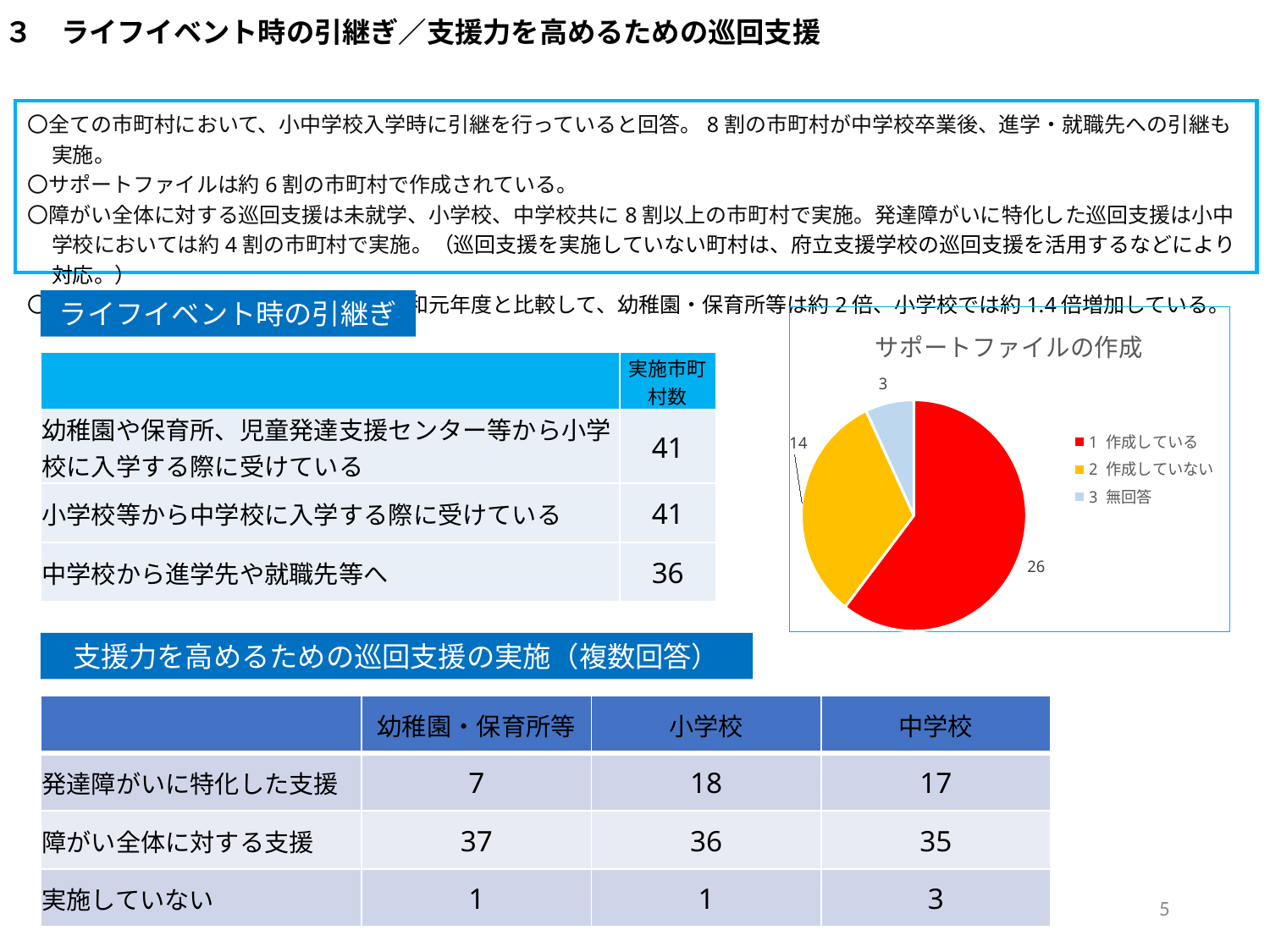
Which category has the smallest slice in the pie chart? 3 無回答 In the pie chart, what is the value for 「1 作成している」? 26 In the pie chart, what is the difference between 「1 作成している」 and 「2 作成していない」? 12 What type of chart is shown on the slide? pie chart In the pie chart, which is larger: 「2 作成していない」 or 「3 無回答」? 2 作成していない What is the total of all slices in the pie chart? 43 What colour is the 「1 作成している」 slice in the pie chart? red What is the title of the pie chart? サポートファイルの作成 Which category has the largest slice in the pie chart? 1 作成している How many categories does the pie chart show? 3 In the pie chart, what is the value for 「2 作成していない」? 14 In the pie chart, what is the value for 「3 無回答」? 3